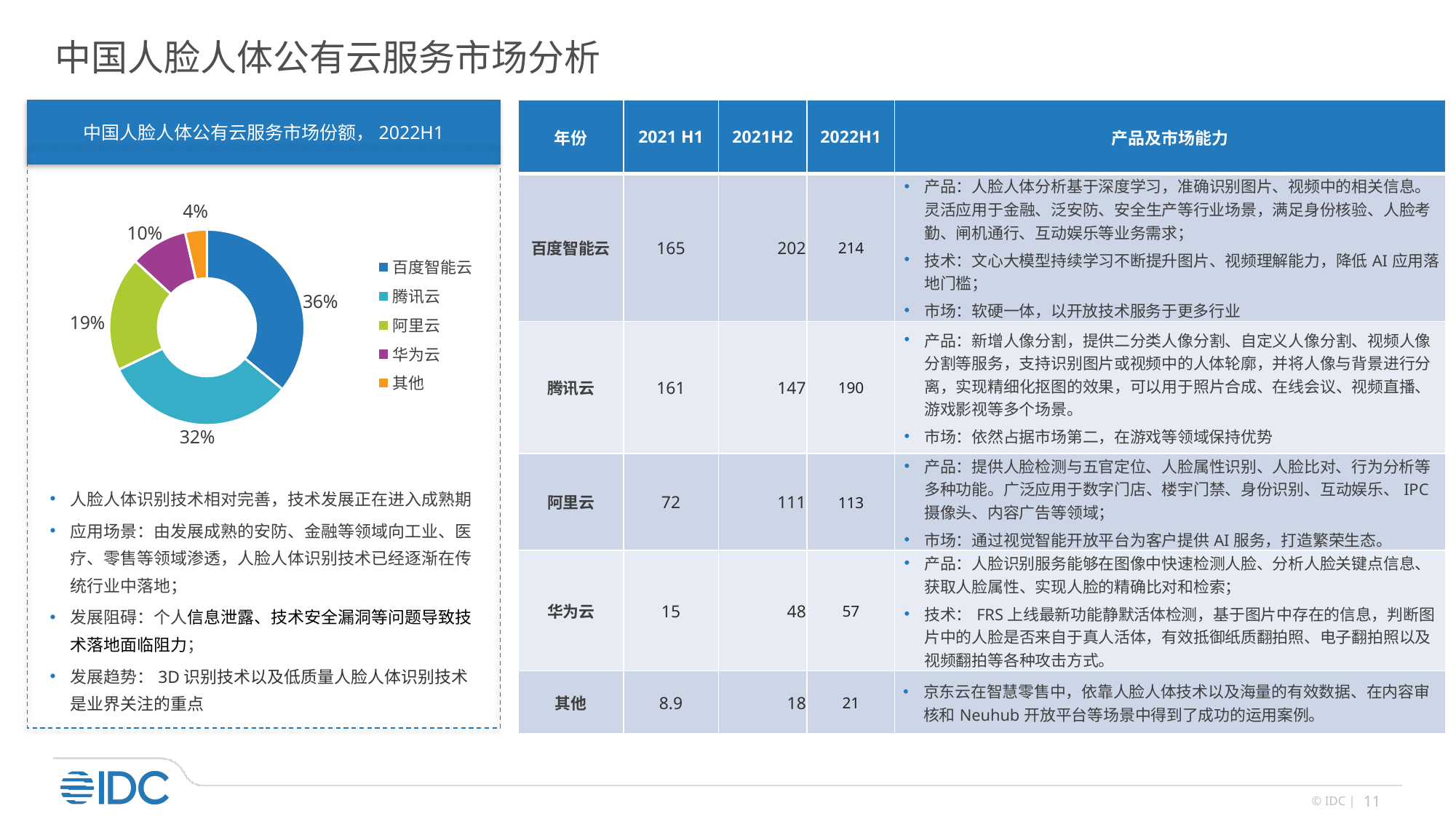
What is the market share of 腾讯云 in the pie chart? 32% What kind of chart is shown on the slide? Pie chart (donut) What is the market share of 华为云 in the pie chart? 10% What is the market share of 阿里云 in the pie chart? 19% What is the difference in share between 百度智能云 and 腾讯云 in the pie chart? 4% Which has a larger share in the pie chart, 阿里云 or 华为云? 阿里云 What is the title of the pie chart? 中国人脸人体公有云服务市场份额，2022H1 How many slices does the pie chart have? 5 Which vendor has the largest share in the pie chart? 百度智能云 What is the market share of 其他 in the pie chart? 4% Which category has the smallest share in the pie chart? 其他 What is the market share of 百度智能云 in the pie chart? 36%